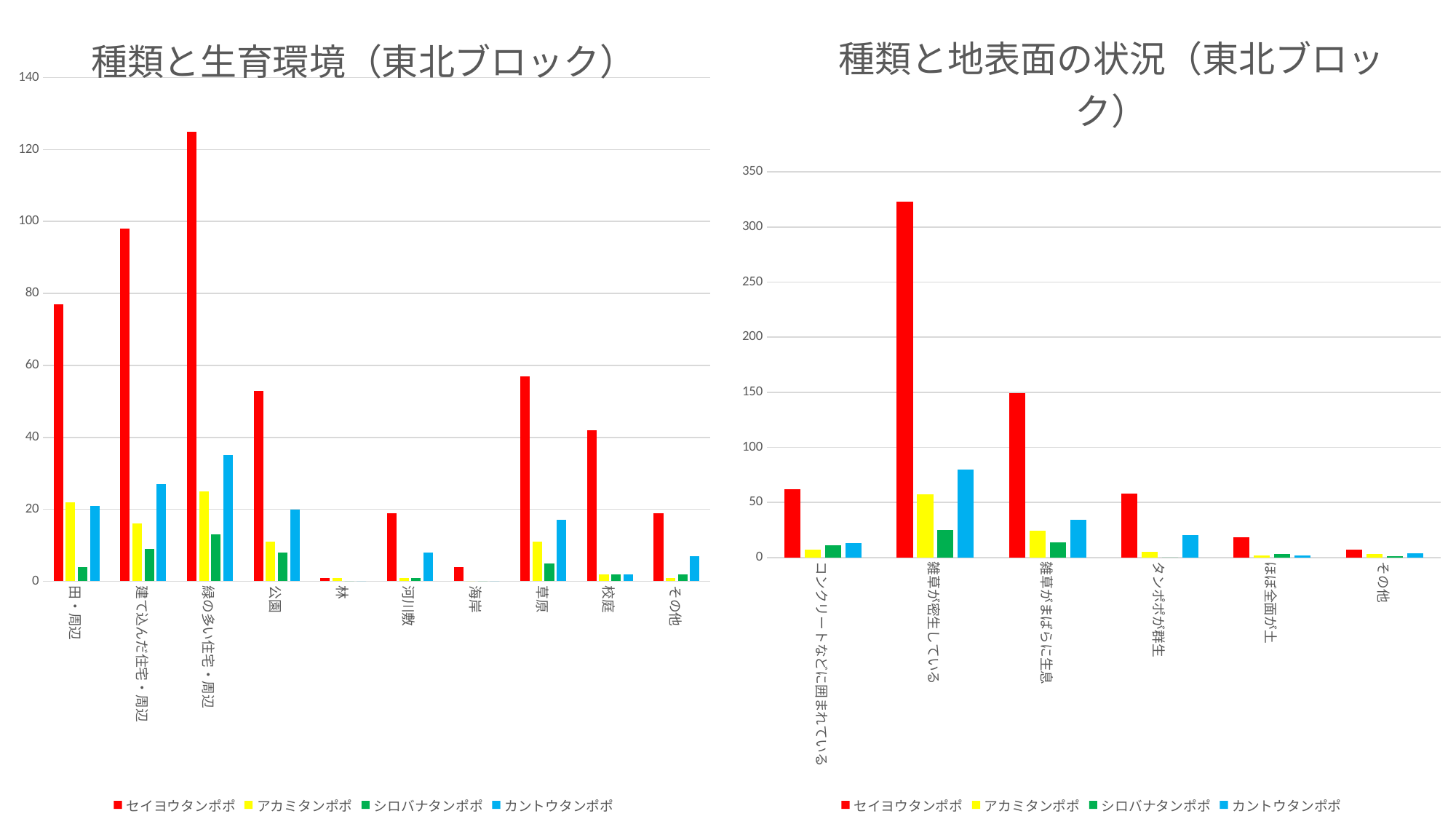
In the right chart 種類と地表面の状況（東北ブロック）, which is larger: the セイヨウタンポポ value for 雑草がまばらに生息 or for タンポポが群生? 雑草がまばらに生息 What kind of chart is the left chart titled 種類と生育環境（東北ブロック）? bar chart How many categories are shown on the x axis of the right chart 種類と地表面の状況（東北ブロック）? 6 In the left chart 種類と生育環境（東北ブロック）, is the セイヨウタンポポ value for 緑の多い住宅・周辺 greater or less than 120? greater What colour represents カントウタンポポ in the legend of the left chart 種類と生育環境（東北ブロック）? blue In the right chart 種類と地表面の状況（東北ブロック）, which category has the highest セイヨウタンポポ value? 雑草が密生している How many series does the legend of the right chart 種類と地表面の状況（東北ブロック） list? 4 In the right chart 種類と地表面の状況（東北ブロック）, is the セイヨウタンポポ value for 雑草が密生している greater or less than 300? greater In the left chart 種類と生育環境（東北ブロック）, which is larger: the セイヨウタンポポ value for 公園 or for 校庭? 公園 In the right chart 種類と地表面の状況（東北ブロック）, is the カントウタンポポ value for 雑草が密生している greater or less than 100? less How many categories are shown on the x axis of the left chart 種類と生育環境（東北ブロック）? 10 In the left chart 種類と生育環境（東北ブロック）, which category has the highest セイヨウタンポポ value? 緑の多い住宅・周辺